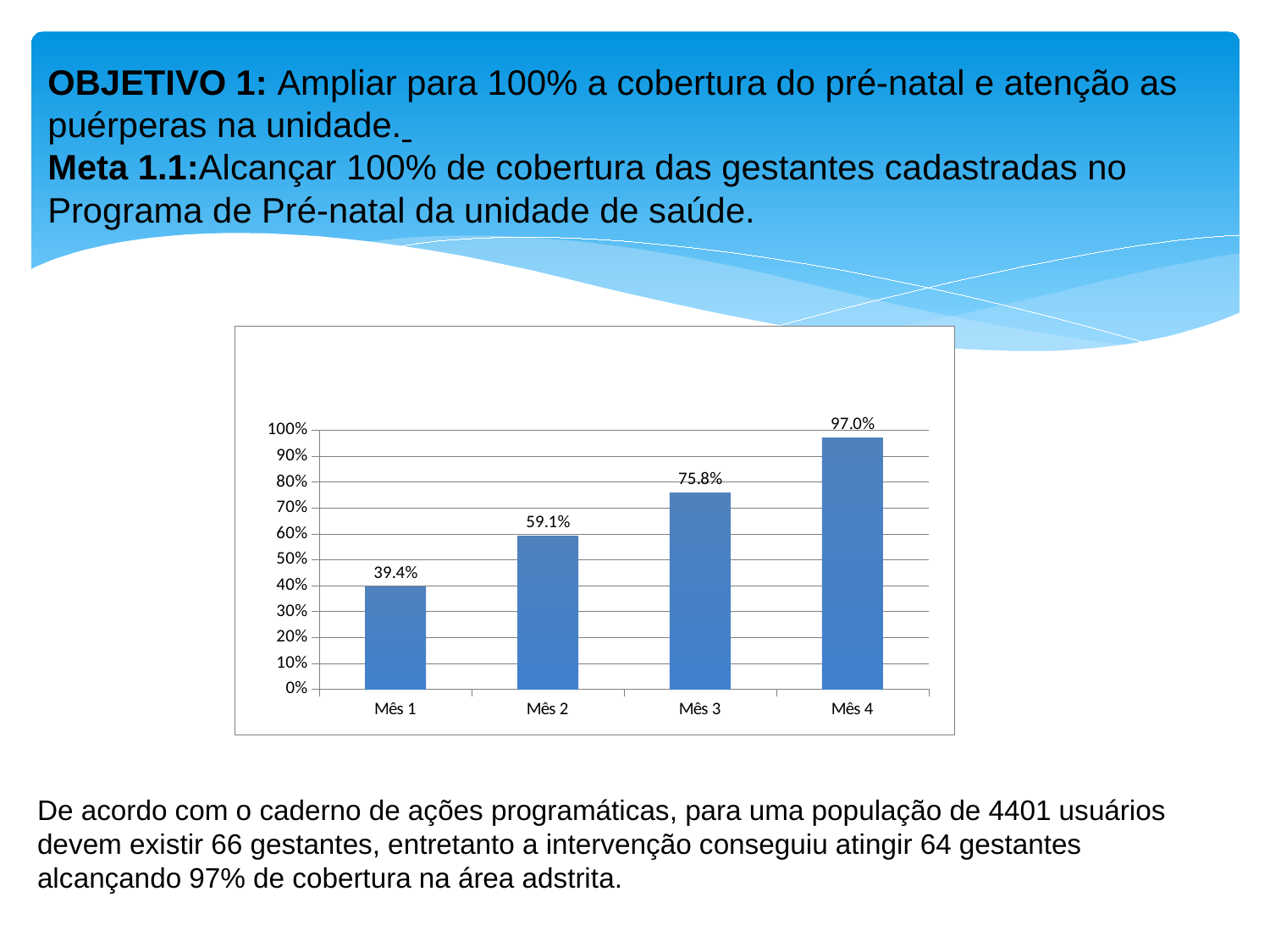
Do the values rise or fall from Mês 1 to Mês 4? rise Which month has the highest value? Mês 4 What is the value for Mês 4? 97.0% Which is larger, the value for Mês 2 or the value for Mês 3? Mês 3 What is the difference between the values for Mês 2 and Mês 1? 19.7% Is the value for Mês 2 greater or less than 50%? greater What is the value for Mês 3? 75.8% What is the value for Mês 1? 39.4% How many months are shown on the x axis? 4 Which month has the lowest value? Mês 1 What kind of chart is shown on the slide? bar chart What is the difference between the values for Mês 4 and Mês 1? 57.6%